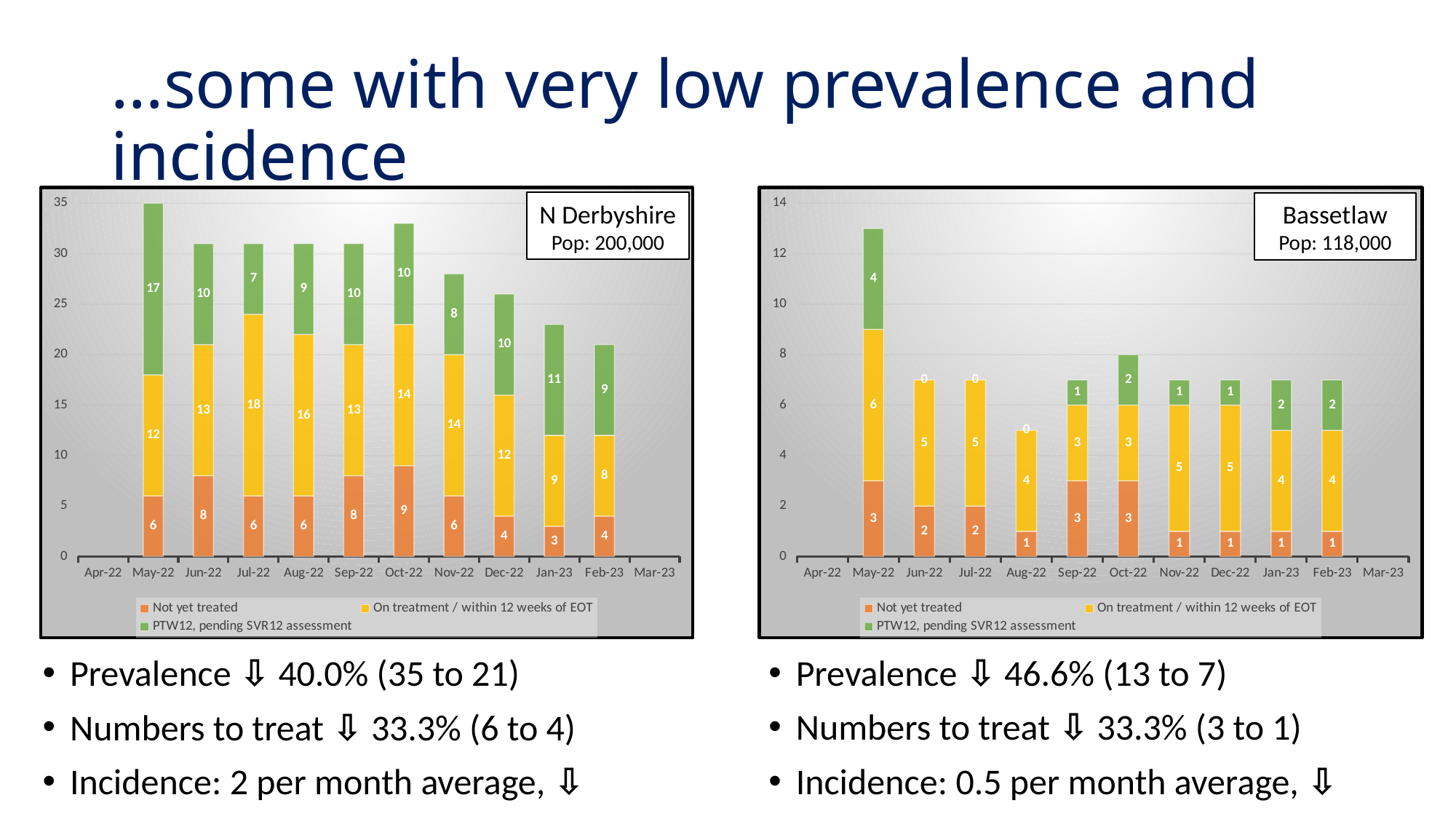
In the N Derbyshire chart, which month has the highest 'PTW12, pending SVR12 assessment' value? May-22 In the Bassetlaw chart, what is the 'PTW12, pending SVR12 assessment' value for May-22? 4 How many series does the legend of the Bassetlaw chart list? 3 In the N Derbyshire chart, what is the total height of the stacked bar for May-22? 35 In the N Derbyshire chart, what is the difference between the 'On treatment / within 12 weeks of EOT' values for Jul-22 and Feb-23? 10 In the Bassetlaw chart, what is the total height of the stacked bar for Oct-22? 8 In the Bassetlaw chart, is the 'Not yet treated' value larger for Sep-22 or for Nov-22? Sep-22 In the N Derbyshire chart, what is the 'Not yet treated' value for May-22? 6 In the N Derbyshire chart, what is the 'On treatment / within 12 weeks of EOT' value for Jul-22? 18 In the Bassetlaw chart, which month has the lowest total stacked bar? Aug-22 In the N Derbyshire chart, is the total stacked bar for Oct-22 greater or less than 30? greater What type of chart is the N Derbyshire chart? Stacked bar chart